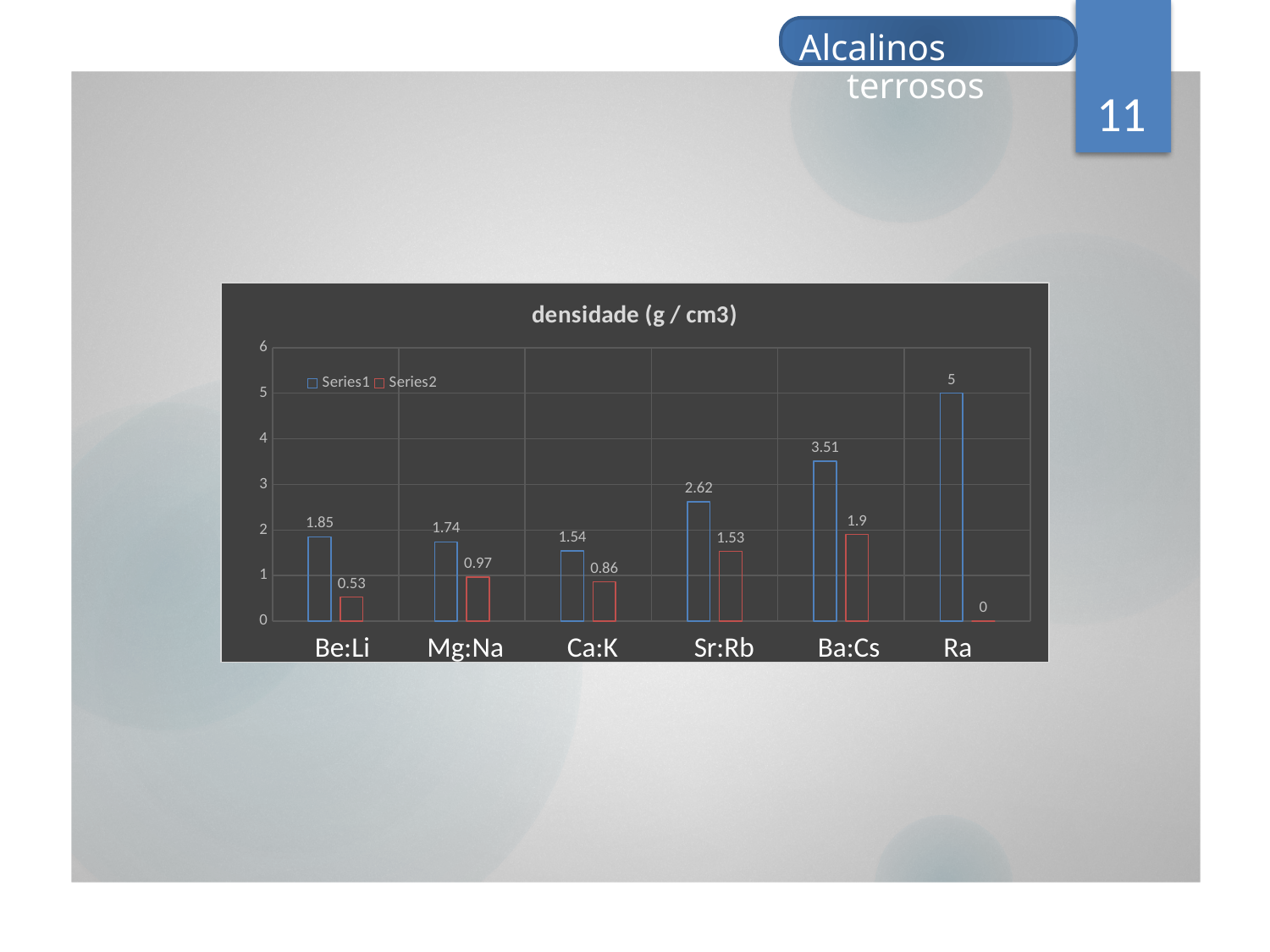
What is the Series1 value for Be:Li? 1.85 What is the Series2 value for Ra? 0 Which category has the highest Series1 value? Ra What kind of chart is shown? Bar chart What is the difference between the Series1 and Series2 values for Sr:Rb? 1.09 What is the Series1 value for Ba:Cs? 3.51 What is the Series2 value for Mg:Na? 0.97 How many categories are shown on the x axis? 6 Which category has the lowest Series2 value? Ra What is the title of the chart? densidade (g / cm3) How many series does the legend list? 2 Which is larger, the Series2 value for Ba:Cs or the Series2 value for Sr:Rb? Ba:Cs